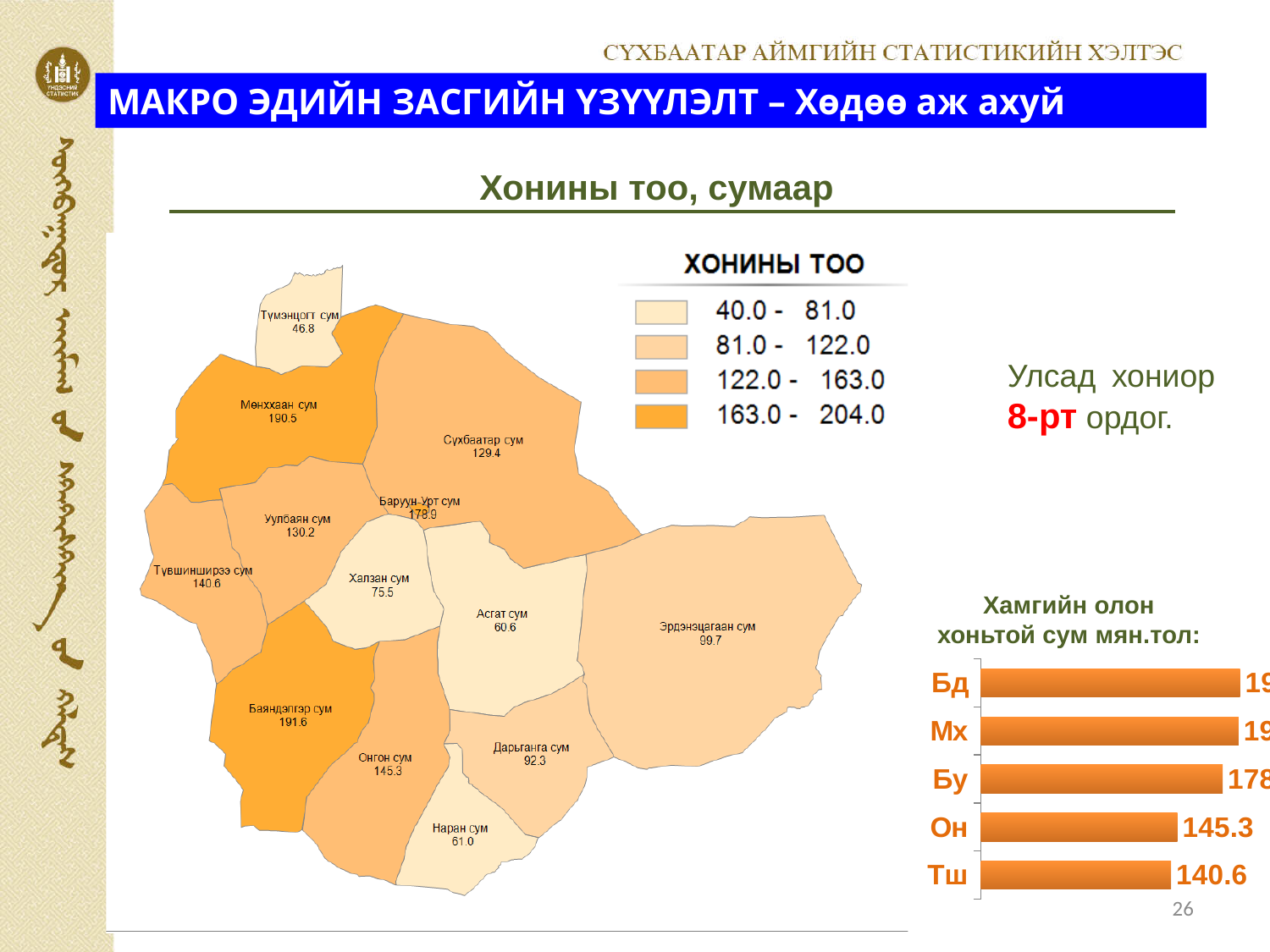
In the bar chart titled 'Хамгийн олон хоньтой сум мян.тол:', what is the value for Он? 145.3 How many categories are shown in the bar chart titled 'Хамгийн олон хоньтой сум мян.тол:'? 5 What kind of chart is the one titled 'Хамгийн олон хоньтой сум мян.тол:'? bar chart On the map titled 'ХОНИНЫ ТОО', what value is shown for Түмэнцогт сум? 46.8 In the bar chart titled 'Хамгийн олон хоньтой сум мян.тол:', which is larger, the value for Он or the value for Тш? Он In the bar chart titled 'Хамгийн олон хоньтой сум мян.тол:', which category has the lowest value? Тш What is the title of the bar chart on the right side of the slide? Хамгийн олон хоньтой сум мян.тол: How many value ranges does the legend of the map titled 'ХОНИНЫ ТОО' list? 4 In the bar chart titled 'Хамгийн олон хоньтой сум мян.тол:', do the values rise or fall going from the top bar to the bottom bar? fall On the map titled 'ХОНИНЫ ТОО', what value is shown for Баяндэлгэр сум? 191.6 In the bar chart titled 'Хамгийн олон хоньтой сум мян.тол:', what is the difference between the values for Он and Тш? 4.7 In the bar chart titled 'Хамгийн олон хоньтой сум мян.тол:', what is the value for Тш? 140.6